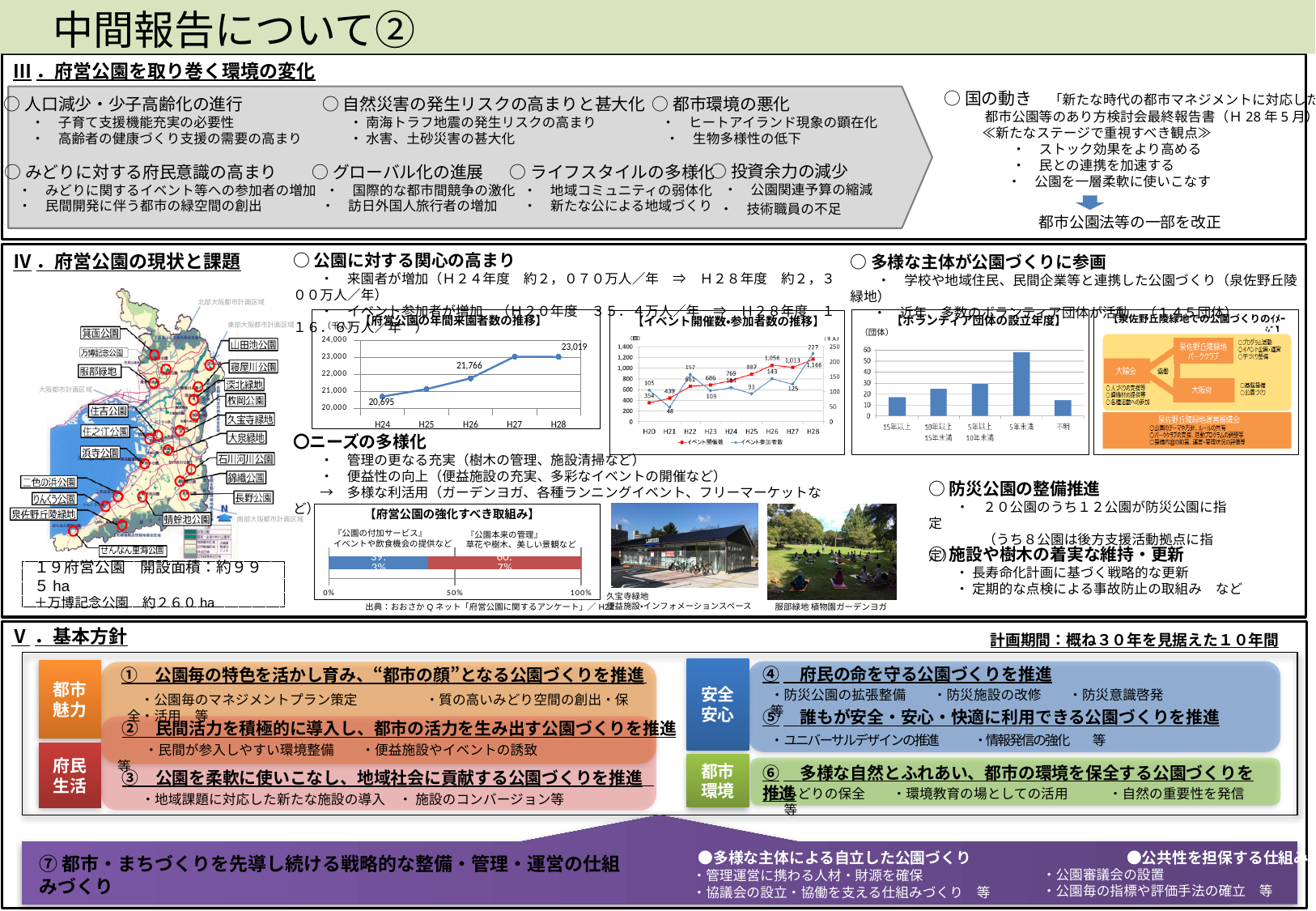
In the chart titled 府営公園の年間来園者数の推移, what is the value for H24? 20,695 In the chart titled 府営公園の年間来園者数の推移, what is the value for H28? 23,019 What kind of chart is ボランティア団体の設立年度? bar chart In the chart titled 府営公園の強化すべき取組み, what is the share for 公園本来の管理? 60.7% In the chart titled ボランティア団体の設立年度, which category has the highest value? 5年未満 In the chart titled ボランティア団体の設立年度, is the value for 5年未満 greater or less than 50? greater In the chart titled 府営公園の年間来園者数の推移, what is the value for H26? 21,766 What kind of chart is 府営公園の年間来園者数の推移? line chart How many series does the legend of the chart titled イベント開催数・参加者数の推移 list? 2 In the chart titled 府営公園の年間来園者数の推移, do the values rise or fall from H24 to H28? rise How many year categories are shown on the x axis of the chart titled イベント開催数・参加者数の推移? 9 In the chart titled 府営公園の年間来園者数の推移, what is the difference between the H28 value and the H24 value? 2,324